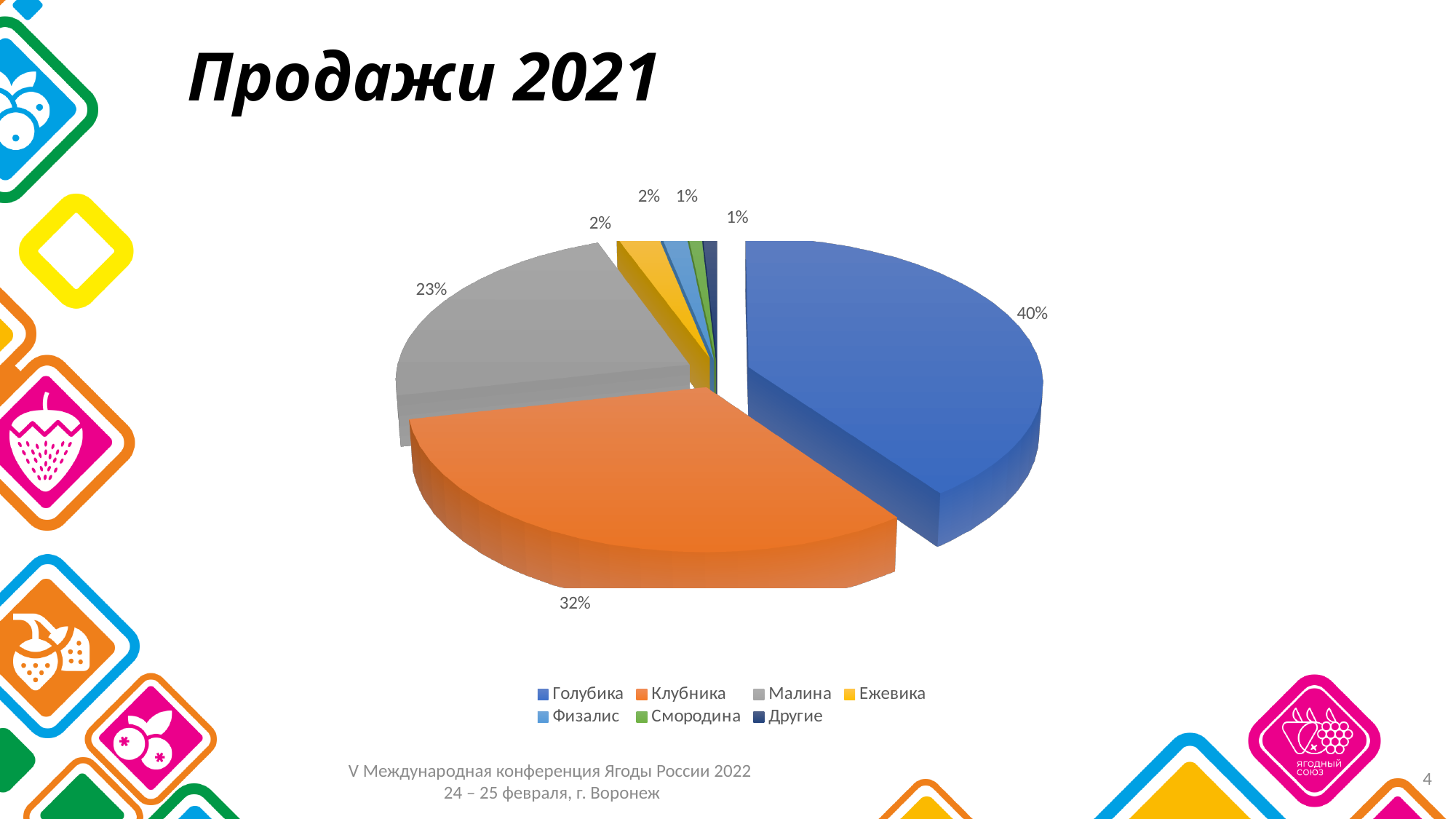
How many categories are shown in the pie chart? 7 What kind of chart is shown on the slide? pie chart What share of sales does Голубика have in the pie chart? 40% What is the value shown for Малина? 23% What is the difference in percentage points between Клубника and Малина? 9 What is the title of the slide containing the chart? Продажи 2021 What is the value shown for Ежевика? 2% What is the value shown for Клубника? 32% How many entries does the legend list? 7 What is the difference in percentage points between Голубика and Клубника? 8 Which is larger, the slice for Клубника or the slice for Малина? Клубника Which category has the largest slice of the pie? Голубика